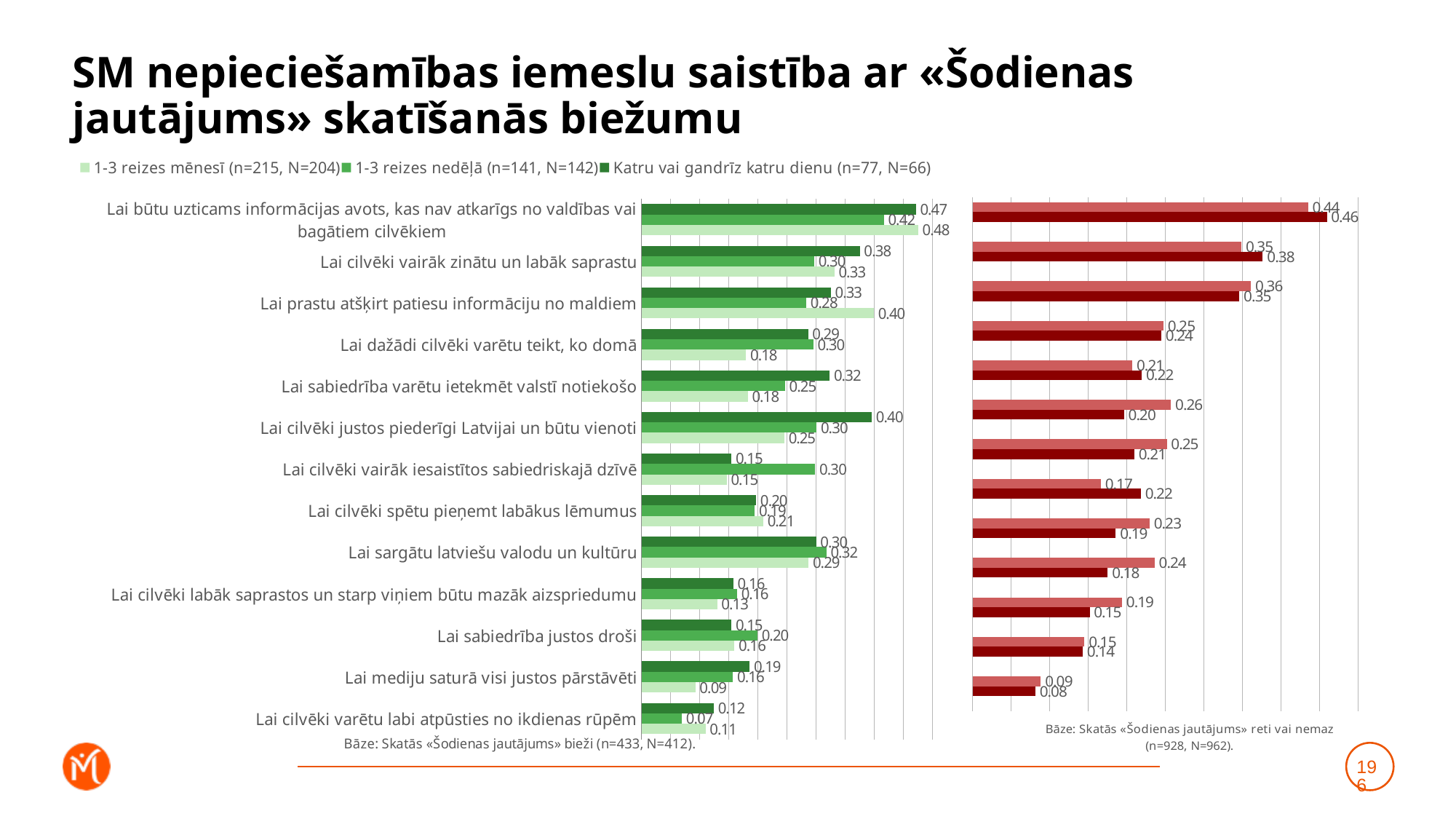
In the left (green) chart, what is the value for «1-3 reizes mēnesī» for «Lai cilvēki spētu pieņemt labākus lēmumus»? 0.21 According to the legend of the left (green) chart, what sample sizes are given for «Katru vai gandrīz katru dienu»? n=77, N=66 In the left (green) chart, for «Lai dažādi cilvēki varētu teikt, ko domā», which is larger: «1-3 reizes nedēļā» or «Katru vai gandrīz katru dienu»? 1-3 reizes nedēļā In the left (green) chart, for «Lai sabiedrība varētu ietekmēt valstī notiekošo», what is the difference between «Katru vai gandrīz katru dienu» and «1-3 reizes mēnesī»? 0.14 In the left (green) chart, what is the value for «1-3 reizes mēnesī» for «Lai prastu atšķirt patiesu informāciju no maldiem»? 0.40 How many categories are shown in the left (green) chart? 13 What kind of chart is the left (green) chart? Bar chart In the left (green) chart, what is the value for «1-3 reizes nedēļā» for «Lai cilvēki vairāk iesaistītos sabiedriskajā dzīvē»? 0.30 In the left (green) chart, which category has the highest value for «1-3 reizes mēnesī»? Lai būtu uzticams informācijas avots, kas nav atkarīgs no valdības vai bagātiem cilvēkiem How many series does the legend of the left (green) chart list? 3 In the left (green) chart, which category has the lowest value for «1-3 reizes nedēļā»? Lai cilvēki varētu labi atpūsties no ikdienas rūpēm In the left (green) chart, what is the value for «Katru vai gandrīz katru dienu» for «Lai cilvēki justos piederīgi Latvijai un būtu vienoti»? 0.40